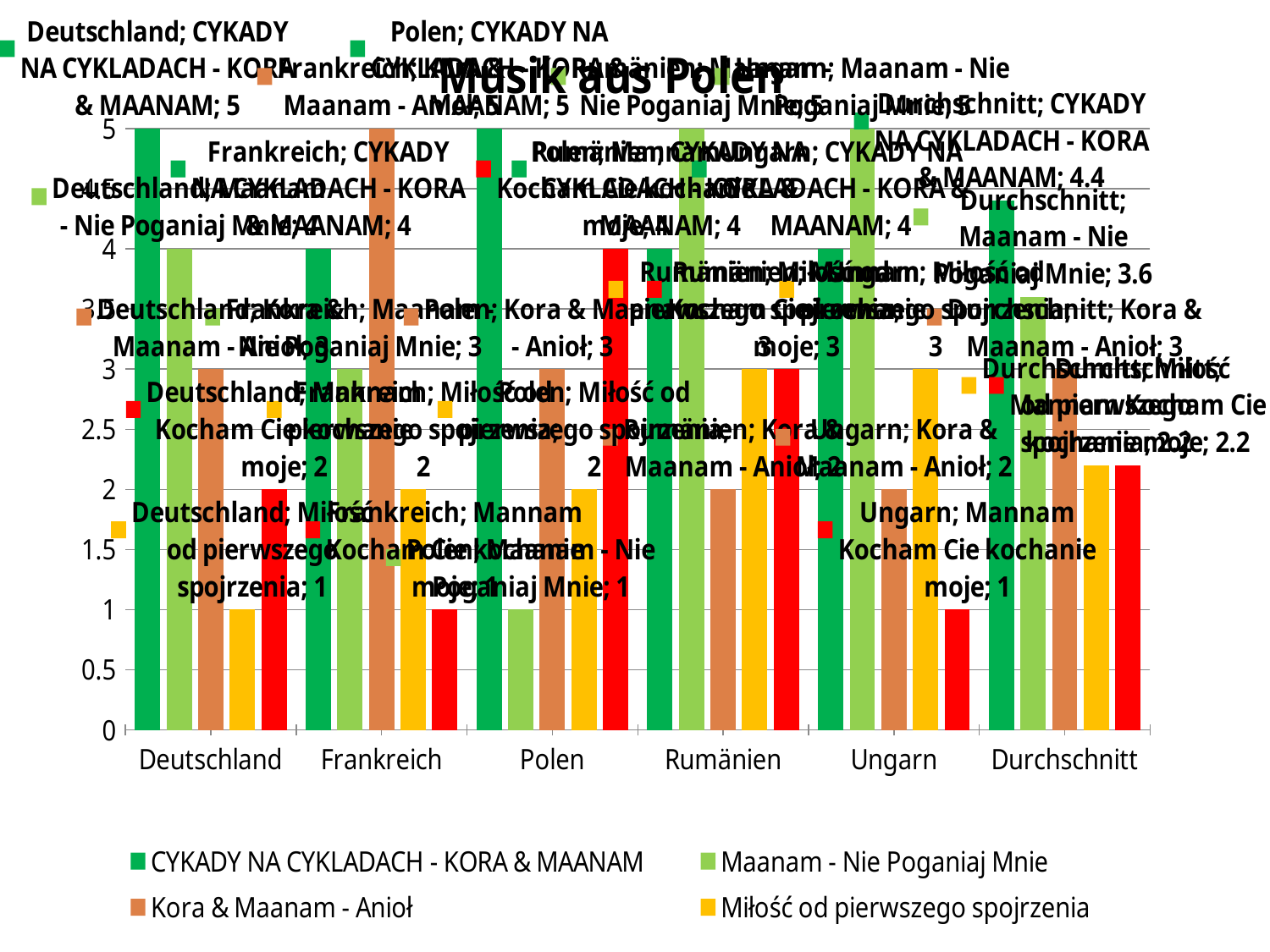
What is the value for Miłość od pierwszego spojrzenia in Deutschland? 1 Which is larger in Deutschland: the value for CYKADY NA CYKLADACH - KORA & MAANAM or the value for Miłość od pierwszego spojrzenia? CYKADY NA CYKLADACH - KORA & MAANAM What is the value for Kora & Maanam - Anioł in Frankreich? 5 What is the difference between the CYKADY NA CYKLADACH - KORA & MAANAM value and the Maanam - Nie Poganiaj Mnie value in Durchschnitt? 0.8 Is the value for Maanam - Nie Poganiaj Mnie in Polen greater or less than 3? less How many categories are shown on the x axis of the chart? 6 What is the value for Maanam - Nie Poganiaj Mnie in Durchschnitt? 3.6 What is the value for CYKADY NA CYKLADACH - KORA & MAANAM in Deutschland? 5 What is the title of the chart? Musik aus Polen What kind of chart is shown on the slide? bar chart How many series does the legend list? 4 What is the value for CYKADY NA CYKLADACH - KORA & MAANAM in Durchschnitt? 4.4